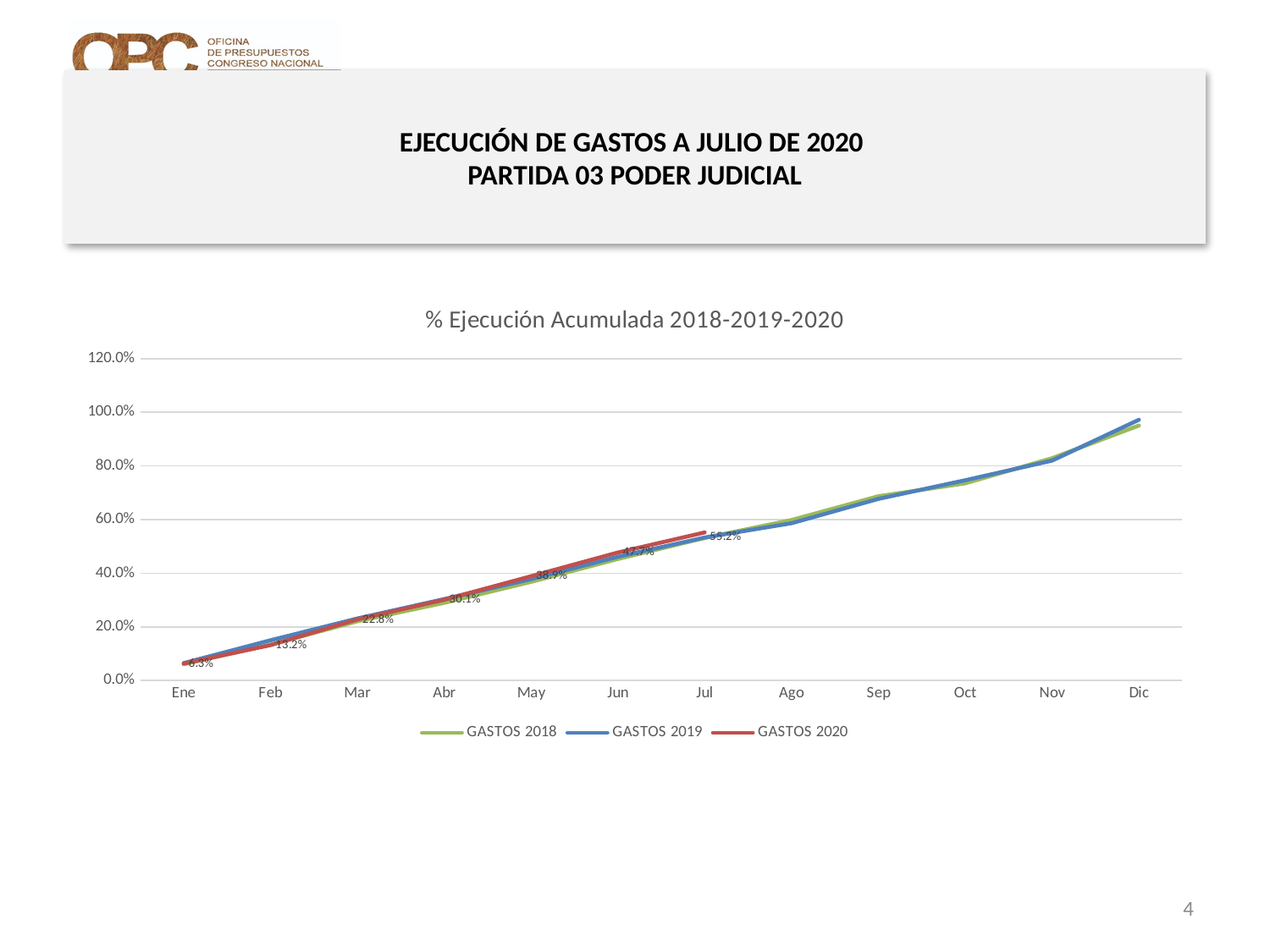
By how many percentage points did GASTOS 2020 increase from Ene to Feb? 6.9 Is the value for GASTOS 2019 in Dic greater or less than 80.0%? greater What is the value of GASTOS 2020 in Jul? 55.2% By how many percentage points did GASTOS 2020 increase from Jun to Jul? 7.5 What is the value of GASTOS 2020 in May? 38.9% How many series does the legend list? 3 What is the value of GASTOS 2020 in Ene? 6.3% Do the lines rise or fall from Ene to Dic? Rise What is the title of the chart? % Ejecución Acumulada 2018-2019-2020 How many months are shown on the x axis? 12 What is the value of GASTOS 2020 in Mar? 22.8% What type of chart is shown on the slide? Line chart